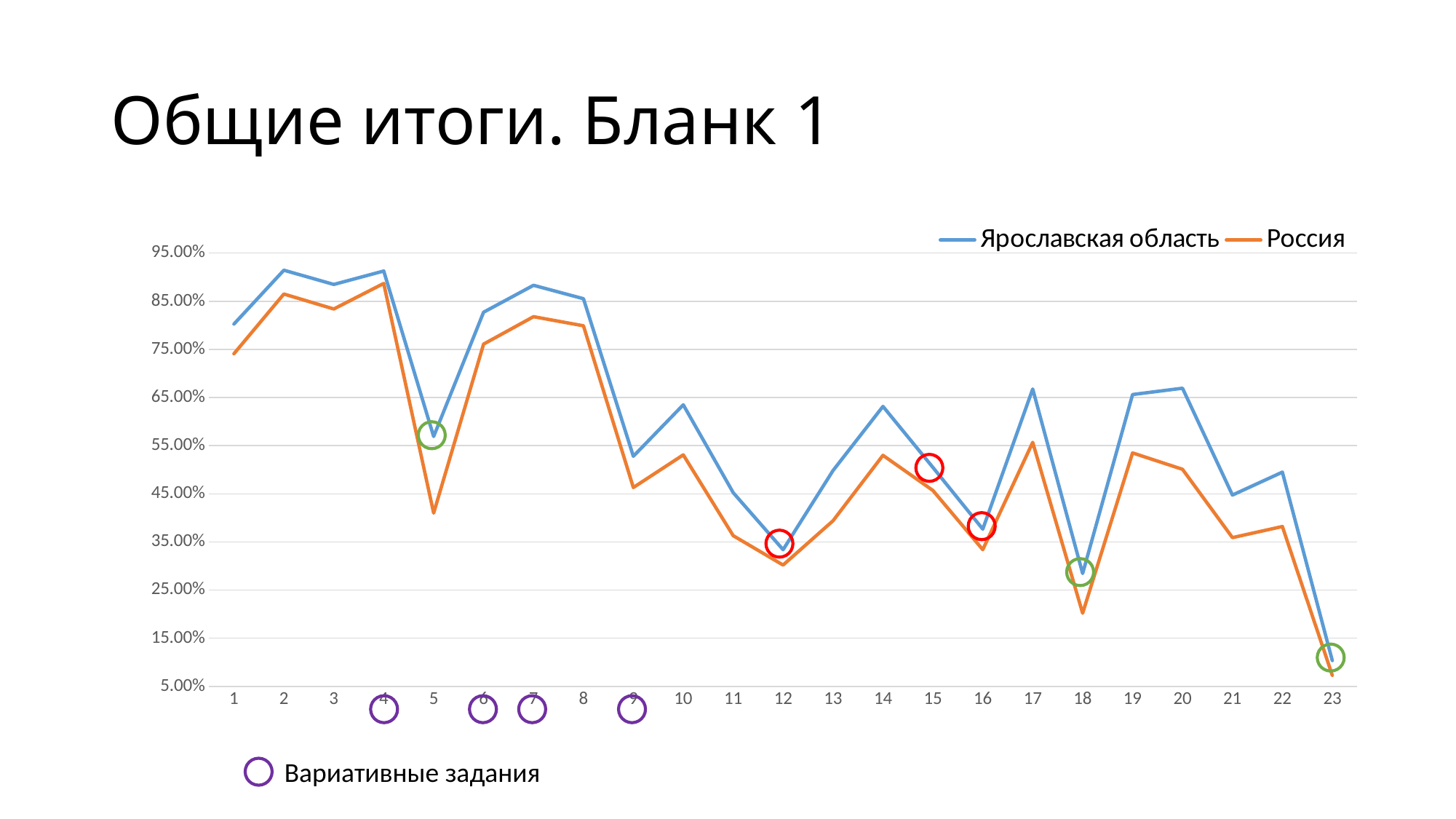
Is the value for Россия at point 18 greater or less than 25.00%? less At which point does the Ярославская область series reach its lowest value? 23 What kind of chart is shown on the slide? line chart How many series does the chart legend list? 2 Which series is drawn in orange? Россия Is the value for Ярославская область at point 1 greater or less than 75.00%? greater How many points (tasks) are plotted along the x axis? 23 At point 5, which series has the higher value, Ярославская область or Россия? Ярославская область Which x-axis labels are marked with purple circles as 'Вариативные задания'? 4, 6, 7, 9 Overall, do the values of the Ярославская область series rise or fall from point 1 to point 23? fall For the Ярославская область series, which is larger: the value at point 17 or at point 18? point 17 At which point does the Россия series reach its lowest value? 23